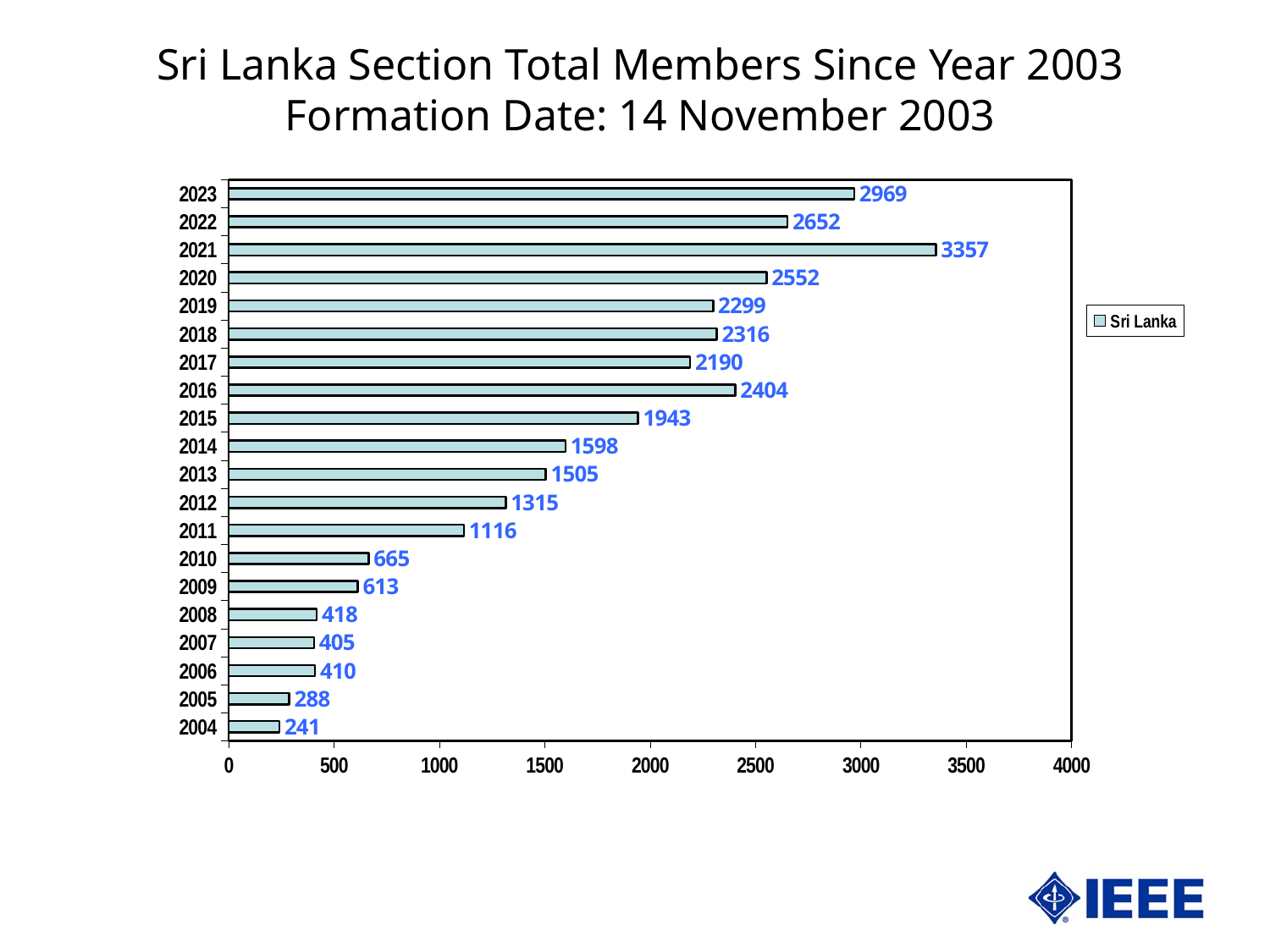
Is the value for 2011 greater or less than 1000? greater What is the value for 2015? 1943 How many years are shown on the chart? 20 What is the difference between the values for 2023 and 2022? 317 What kind of chart is this? bar chart What is the legend entry for the series? Sri Lanka Which year has the lowest value? 2004 What is the value for 2021? 3357 Which is larger, the value for 2018 or the value for 2019? 2018 What is the value for 2004? 241 How many series does the legend list? 1 Which year has the highest value? 2021